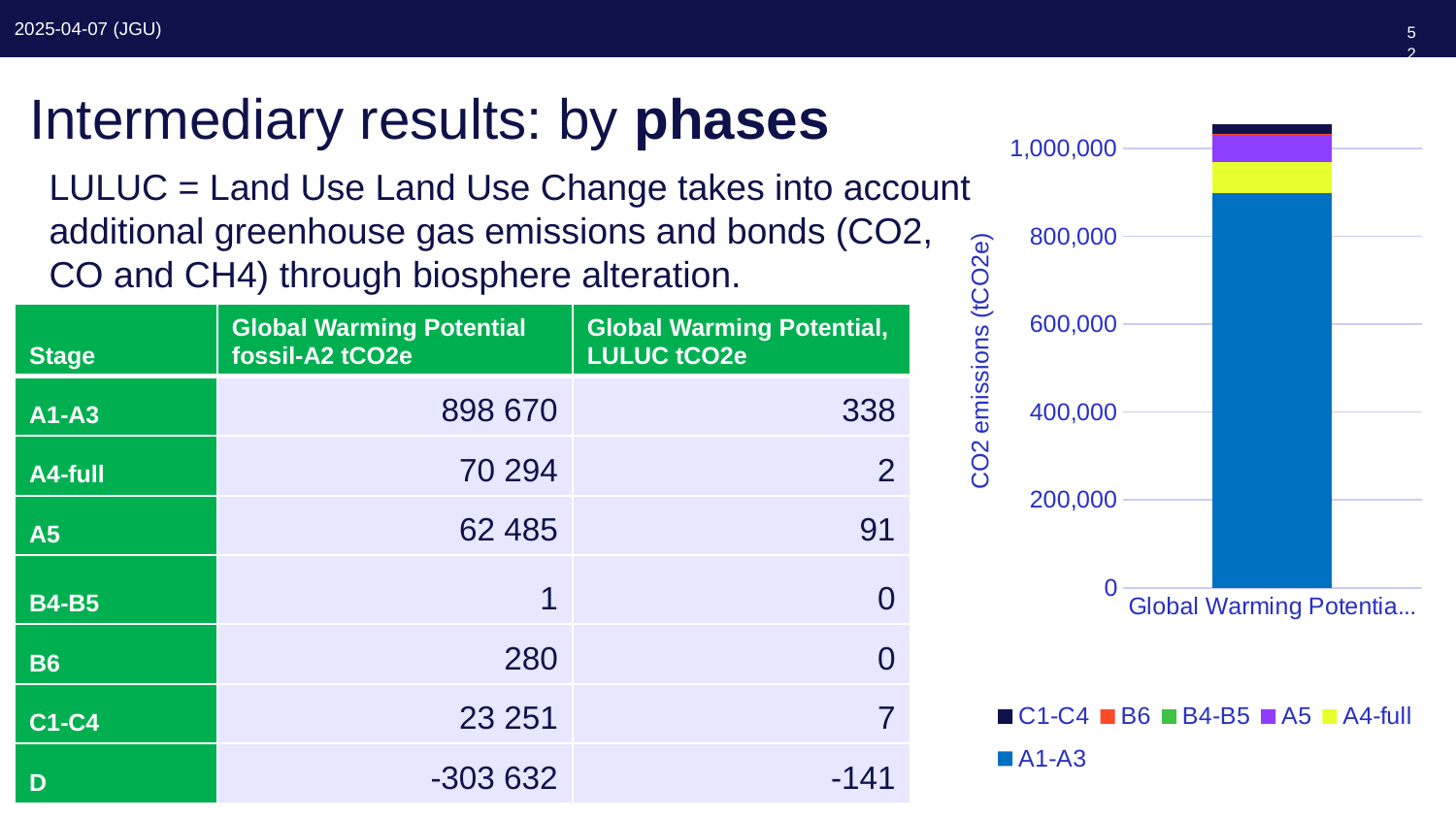
Which segment is larger in the stacked bar, A1-A3 or A5? A1-A3 How many bars (categories) are plotted in the chart? 1 What colour represents the A1-A3 series in the chart? blue Is the total height of the stacked bar greater or less than 1,000,000? greater Which series forms the largest segment of the stacked bar? A1-A3 What is the highest value labelled on the chart's vertical axis? 1,000,000 How many series does the chart legend list? 6 What kind of chart is shown on the right of the slide? stacked bar chart Is the A1-A3 segment of the stacked bar greater or less than 800,000? greater Is the A1-A3 segment of the stacked bar greater or less than 1,000,000? less What is the title of the chart's vertical axis? CO2 emissions (tCO2e)